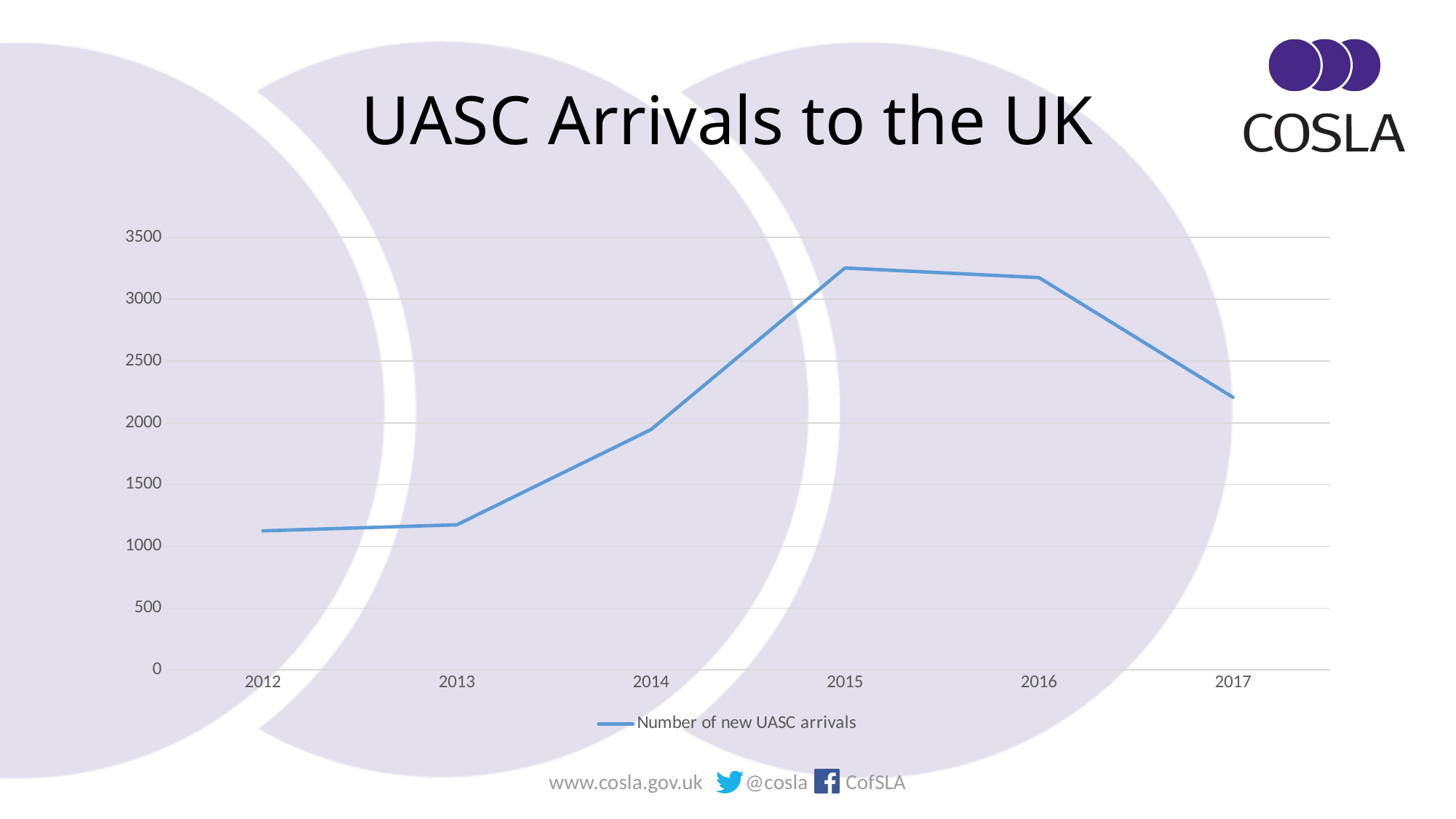
In which year is the number of new UASC arrivals highest? 2015 What is the legend entry for the plotted line? Number of new UASC arrivals How many series does the legend list? 1 Which year has the larger number of new UASC arrivals, 2014 or 2016? 2016 Is the value for 2012 greater or less than 1500? less How many years are plotted on the x axis? 6 Is the value for 2015 greater or less than 3000? greater Is the value for 2017 greater or less than 2500? less What kind of chart is shown on the slide? line chart What is the title of the chart? UASC Arrivals to the UK Do the values rise or fall from 2012 to 2015? rise